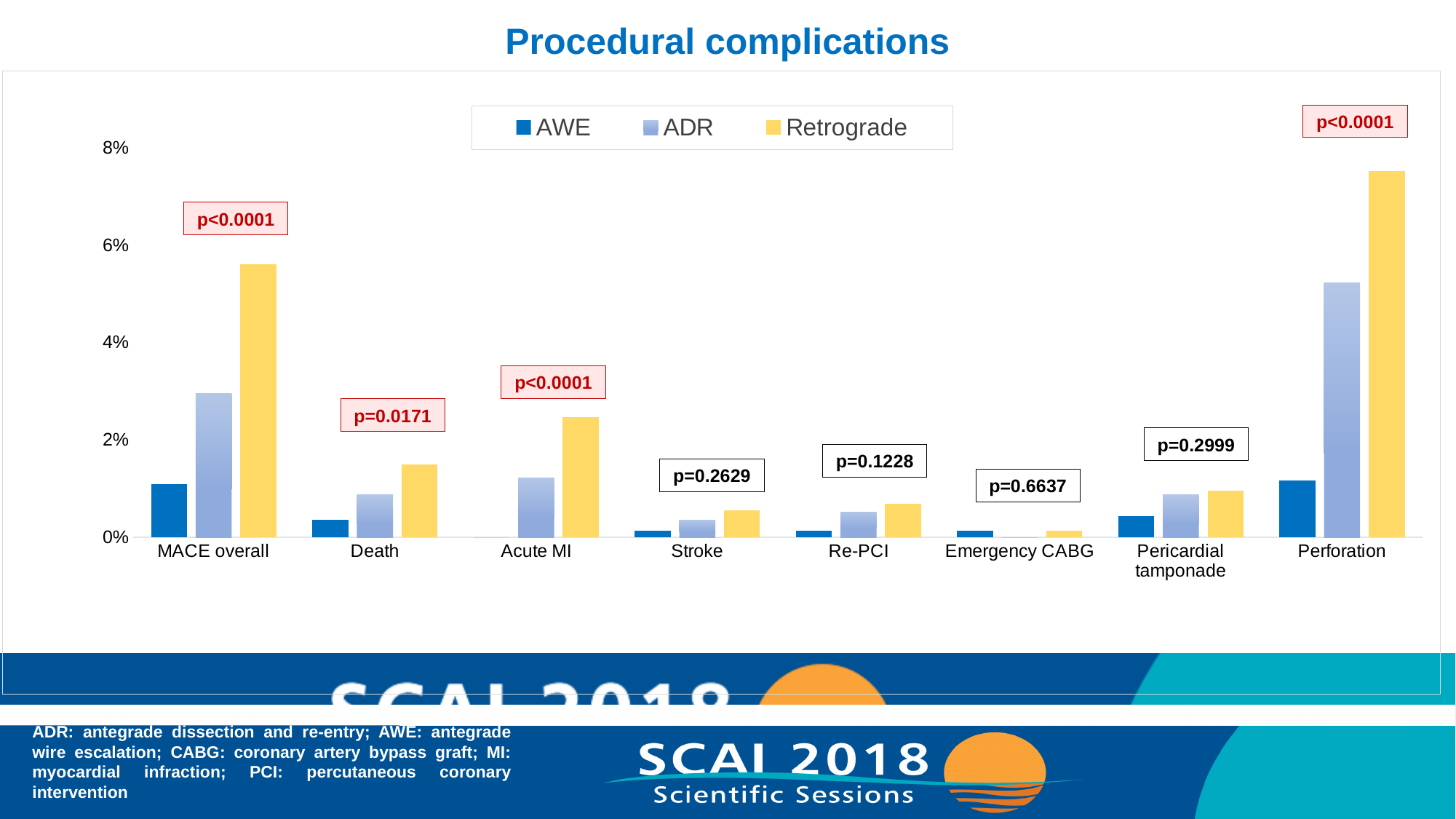
How many series does the legend list? 3 Is the ADR value for Perforation greater or less than 4%? greater What p-value is shown for Death? p=0.0171 What kind of chart is shown on the slide? bar chart What p-value is shown above the Perforation bars? p<0.0001 For Acute MI, which series has the larger value, ADR or Retrograde? Retrograde For which category is the Retrograde bar the highest? Perforation Is the AWE value for MACE overall greater or less than 2%? less Is the Retrograde value for Perforation greater or less than 6%? greater For which category is the ADR bar the highest? Perforation How many complication categories are shown on the x axis? 8